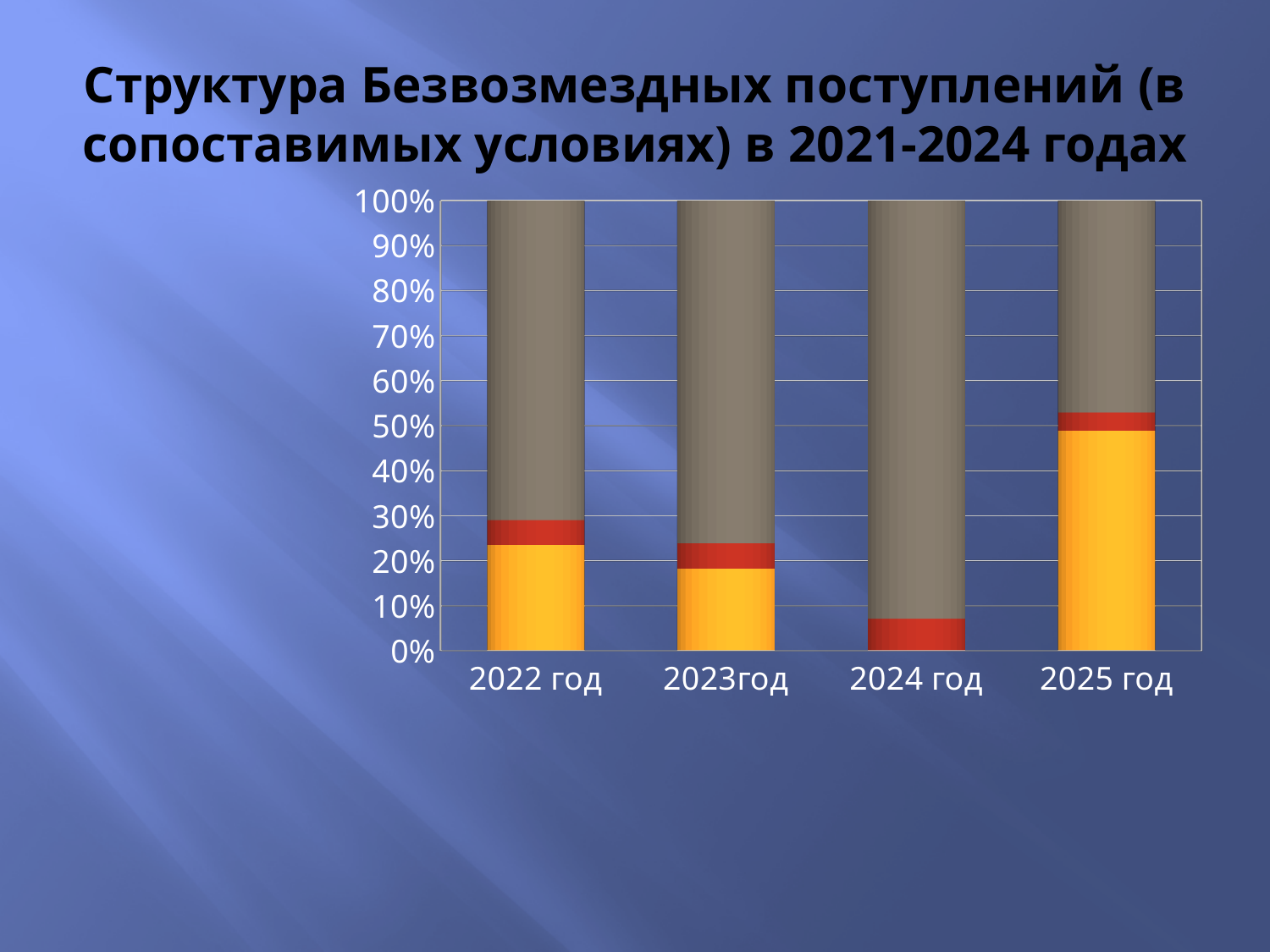
Which year has the largest grey (top) segment in the chart? 2024 год What kind of chart is shown on the slide? stacked bar chart What is the title of the slide containing the chart? Структура Безвозмездных поступлений (в сопоставимых условиях) в 2021-2024 годах Is the top of the red segment for 2024 год greater or less than 10%? less How many categories (years) are shown on the x axis of the chart? 4 Is the yellow (bottom) segment for 2022 год greater or less than 30%? less Which year has the larger yellow (bottom) segment, 2022 год or 2023год? 2022 год Is the yellow (bottom) segment for 2025 год greater or less than 40%? greater Which year has the largest yellow (bottom) segment in the chart? 2025 год Which year has the smallest yellow (bottom) segment in the chart? 2024 год What is the maximum value shown on the vertical axis of the chart? 100%